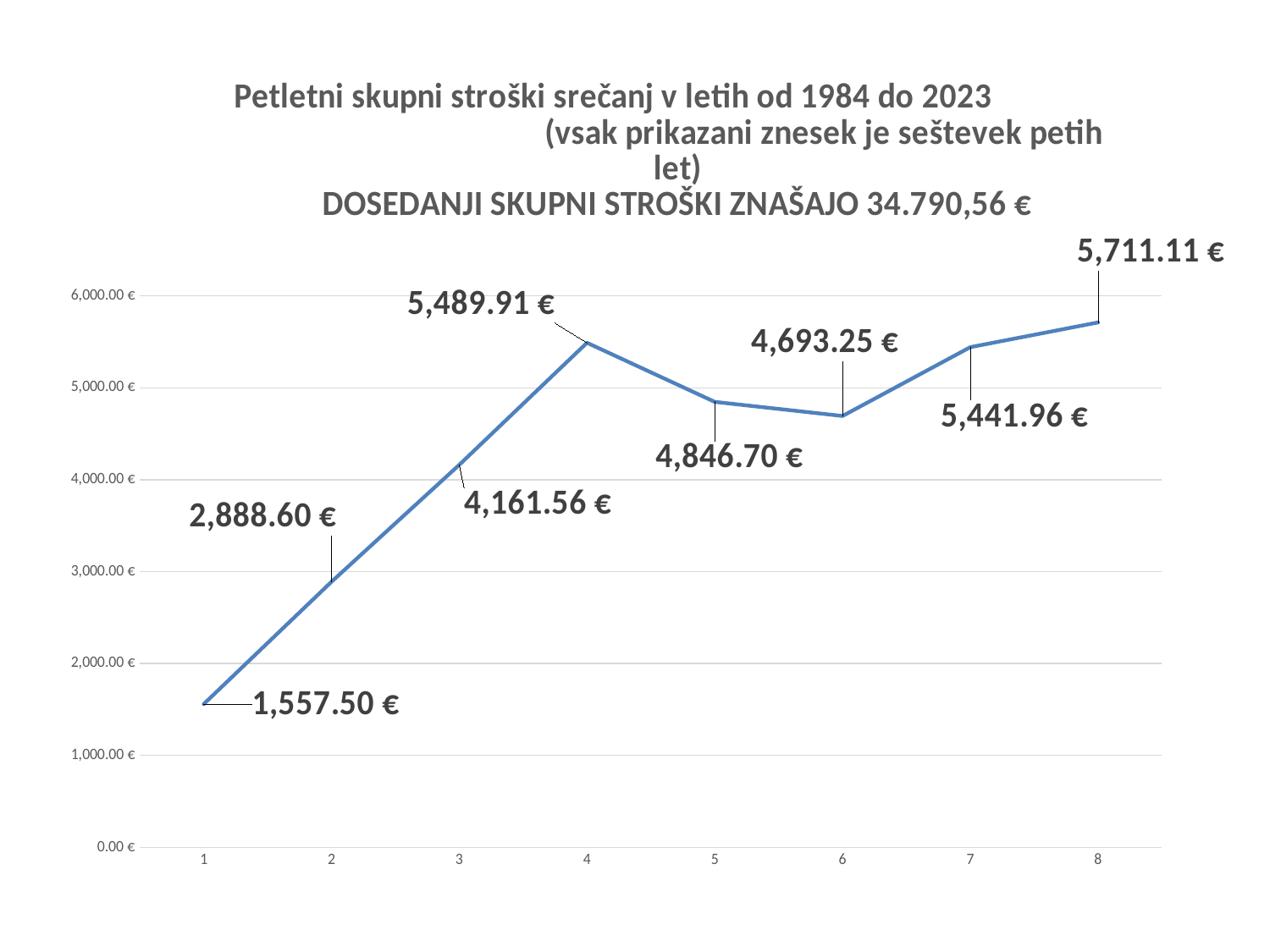
Is the value for point 6 greater or less than 5,000.00 €? less What is the difference between the value at point 4 and the value at point 5? 643.21 € Which point on the x axis has the lowest value? 1 How many data points are plotted on the chart? 8 Which has the larger value, point 2 or point 3? Point 3 What is the value for point 6 on the chart? 4,693.25 € What is the value for point 4 on the chart? 5,489.91 € What is the value for point 1 on the chart? 1,557.50 € What kind of chart is shown on the slide? Line chart What is the value for point 8 on the chart? 5,711.11 € What is the difference between the value at point 8 and the value at point 1? 4,153.61 € Which point on the x axis has the highest value? 8